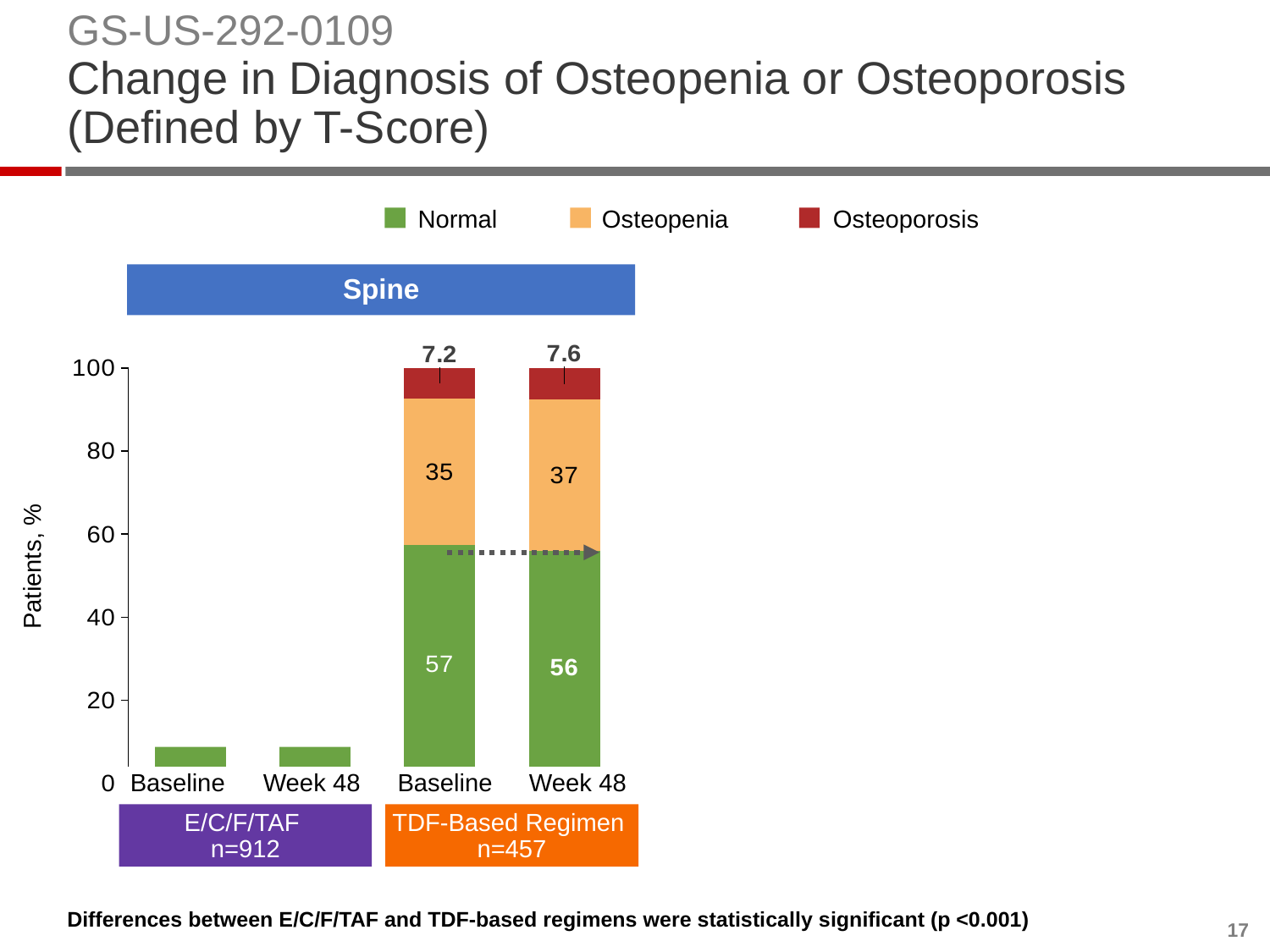
In the TDF-Based Regimen group at Baseline, which is larger: the Normal value or the Osteopenia value? Normal What is the Osteoporosis value for the TDF-Based Regimen group at Baseline? 7.2 How many series does the legend list? 3 What is the Normal value for the TDF-Based Regimen group at Week 48? 56 By how much did the Osteopenia value in the TDF-Based Regimen group change from Baseline (35) to Week 48 (37)? 2 What is the Osteoporosis value for the TDF-Based Regimen group at Week 48? 7.6 What is the label of the y axis? Patients, % What percentage of patients in the TDF-Based Regimen group had a Normal spine diagnosis at Baseline? 57 What is the Osteopenia value for the TDF-Based Regimen group at Week 48? 37 What is the difference between the Osteoporosis values at Week 48 (7.6) and Baseline (7.2) in the TDF-Based Regimen group? 0.4 What kind of chart is shown on the slide? Stacked bar chart